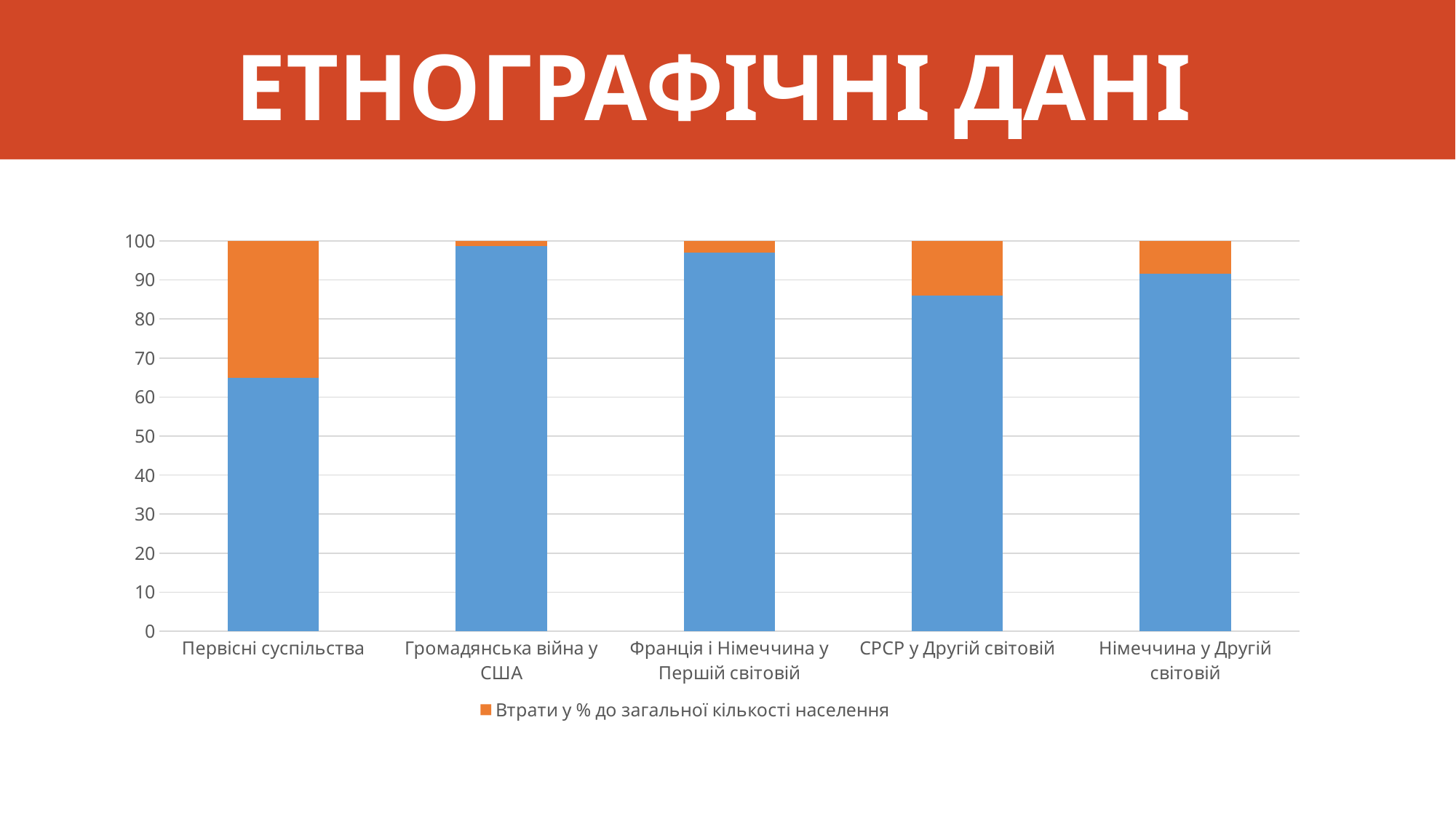
What series name does the chart legend show? Втрати у % до загальної кількості населення Which has the larger orange segment (Втрати у % до загальної кількості населення): СРСР у Другій світовій or Німеччина у Другій світовій? СРСР у Другій світовій What is the total height of the stacked bar for СРСР у Другій світовій? 100 Is the orange segment (Втрати у % до загальної кількості населення) for СРСР у Другій світовій greater or less than 10? greater Which category has the largest orange segment (Втрати у % до загальної кількості населення)? Первісні суспільства Is the orange segment (Втрати у % до загальної кількості населення) for Первісні суспільства greater or less than 30? greater How many series does the chart legend list? 1 Is the blue segment for Первісні суспільства greater or less than 70? less What kind of chart is shown on the slide? Stacked bar chart Which has the larger orange segment (Втрати у % до загальної кількості населення): Первісні суспільства or Громадянська війна у США? Первісні суспільства How many categories are shown on the x axis of the chart? 5